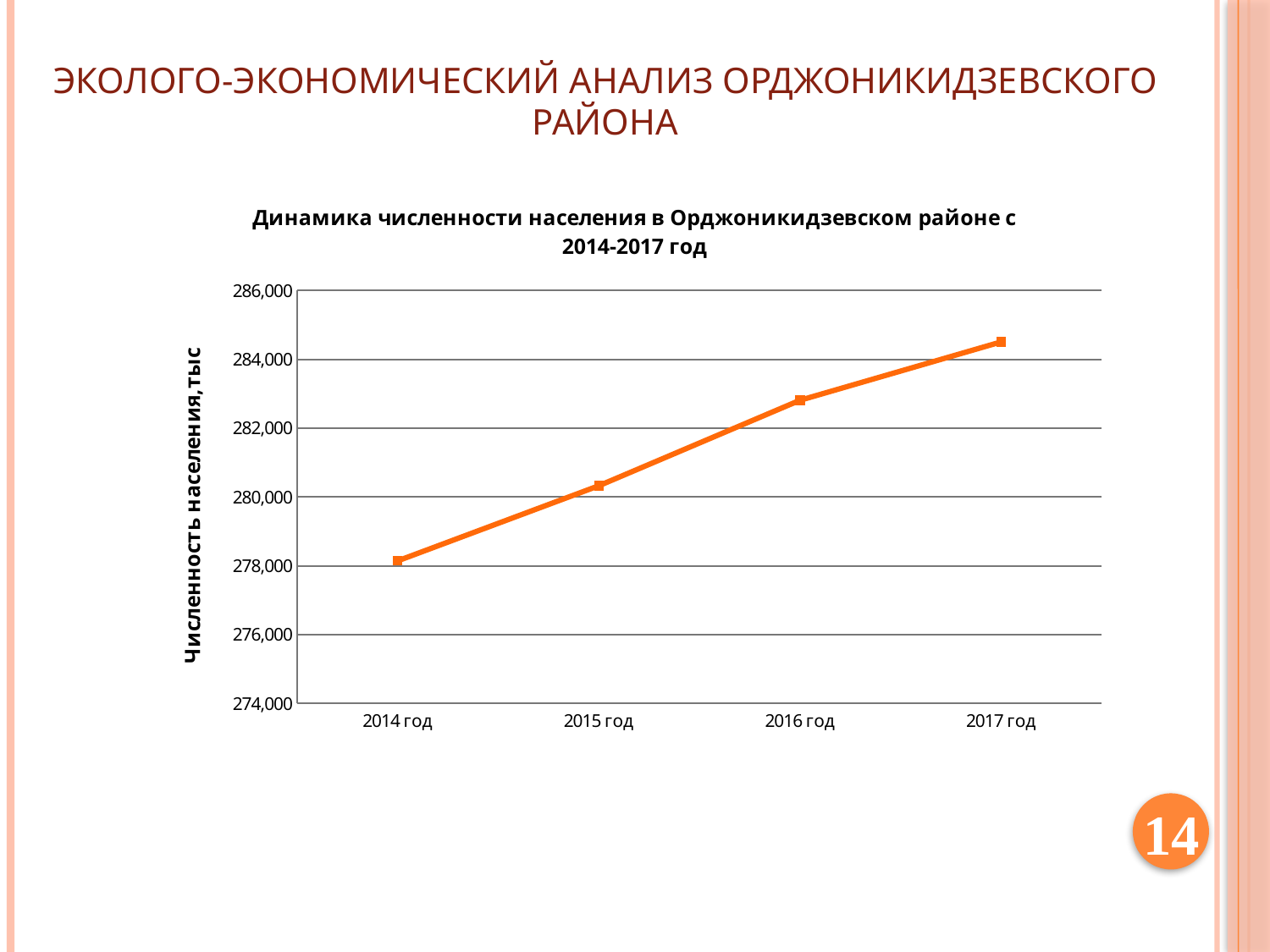
Is the value for 2016 год greater or less than 282,000? greater Is the value for 2014 год greater or less than 280,000? less What is the label of the vertical axis? Численность населения,тыс Is the value for 2017 год greater or less than 284,000? greater Do the values rise or fall from 2014 год to 2017 год? rise Which year has the highest population value on the chart? 2017 год How many data points are plotted on the chart? 4 Which is larger, the value for 2015 год or the value for 2016 год? 2016 год What kind of chart is shown on the slide? line chart Which year has the lowest population value on the chart? 2014 год What is the title of the chart? Динамика численности населения в Орджоникидзевском районе с 2014-2017 год